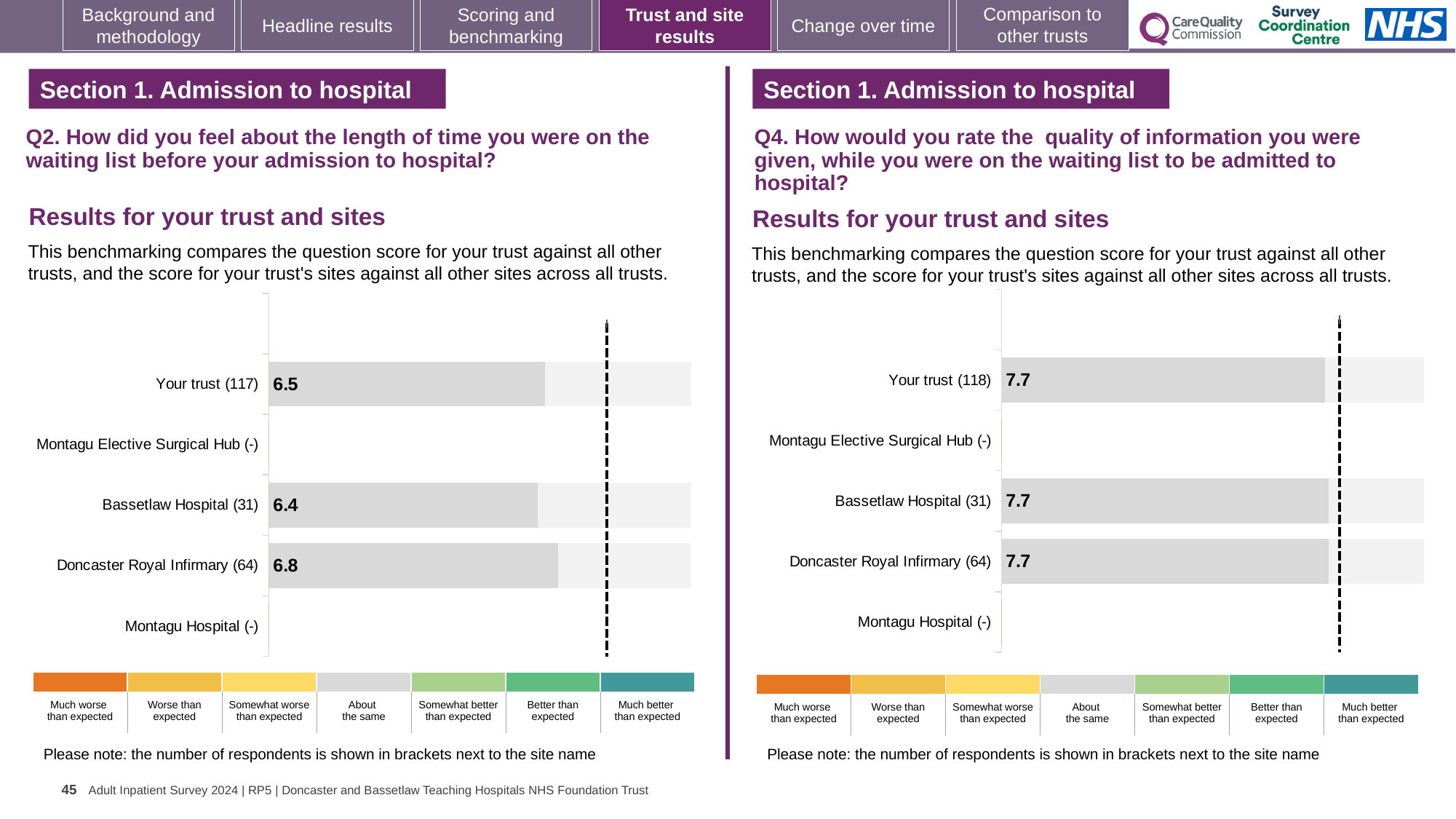
On the Q2 chart (left), which site or trust has the highest score? Doncaster Royal Infirmary On the Q4 chart (right), what is the score for Bassetlaw Hospital? 7.7 What kind of chart is used on the Q2 chart (left)? Bar chart On the Q2 chart (left), which site or trust has the lowest score among those with a bar? Bassetlaw Hospital On the Q4 chart (right), how many respondents are shown in brackets for Your trust? 118 On the Q2 chart (left), what is the score for Your trust? 6.5 On the Q4 chart (right), how many categories are listed on the vertical axis? 5 On the Q4 chart (right), what is the score for Your trust? 7.7 On the Q2 chart (left), what is the score for Doncaster Royal Infirmary? 6.8 On the Q2 chart (left), what is the difference between the scores for Doncaster Royal Infirmary and Bassetlaw Hospital? 0.4 On the Q2 chart (left), which has the larger score, Your trust or Doncaster Royal Infirmary? Doncaster Royal Infirmary On the Q2 chart (left), what is the score for Bassetlaw Hospital? 6.4